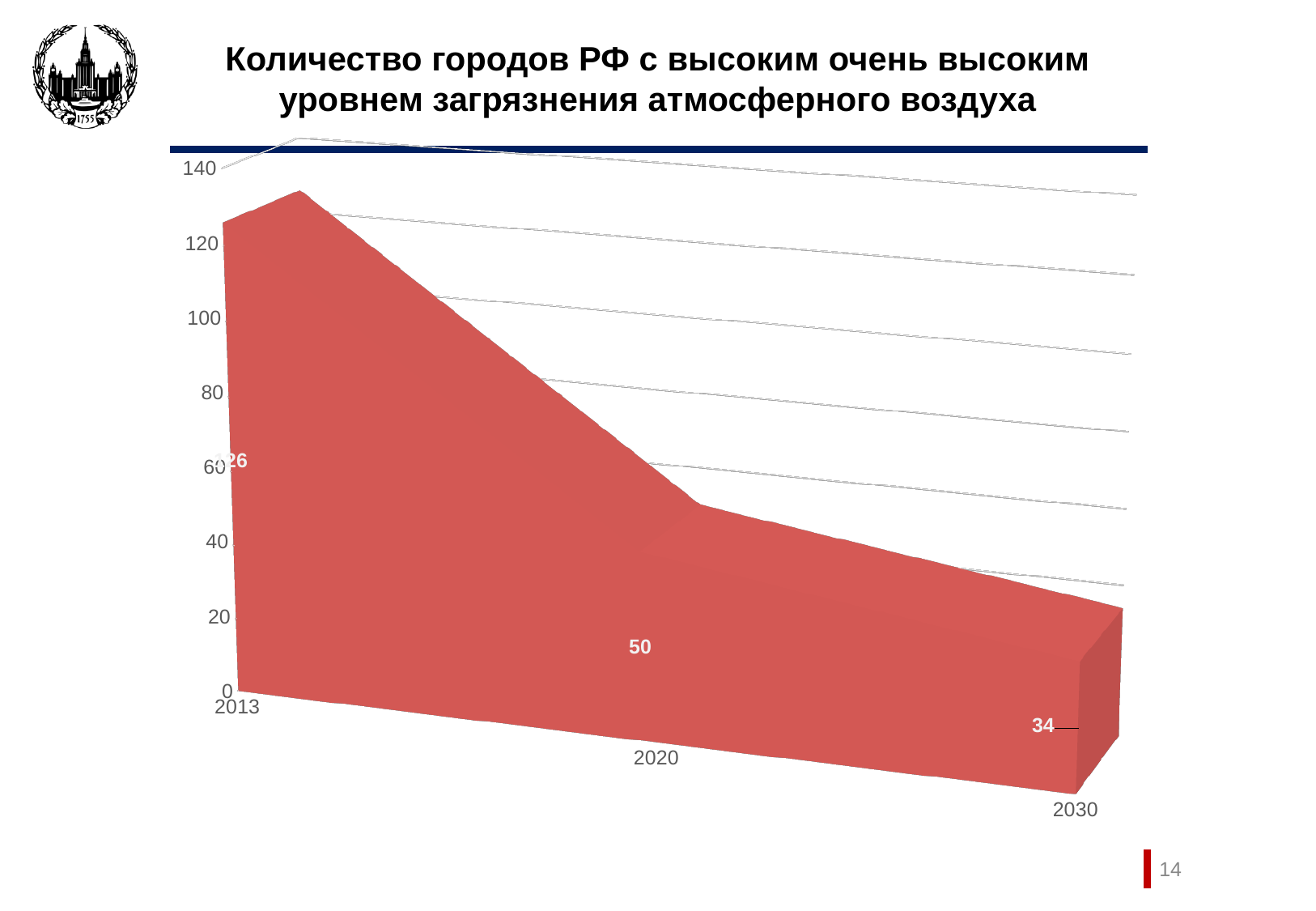
Is the value for 2020 greater or less than 80? less What is the difference between the values for 2020 and 2030? 16 What kind of chart is shown on the slide? area chart What is the value for 2030? 34 How many years are plotted on the chart? 3 Which is larger, the value for 2020 or the value for 2030? 2020 What is the title of the chart? Количество городов РФ с высоким очень высоким уровнем загрязнения атмосферного воздуха Is the value for 2013 greater or less than 100? greater Which year has the highest value? 2013 Which year has the lowest value? 2030 Do the values rise or fall from 2013 to 2030? fall What is the value for 2020? 50